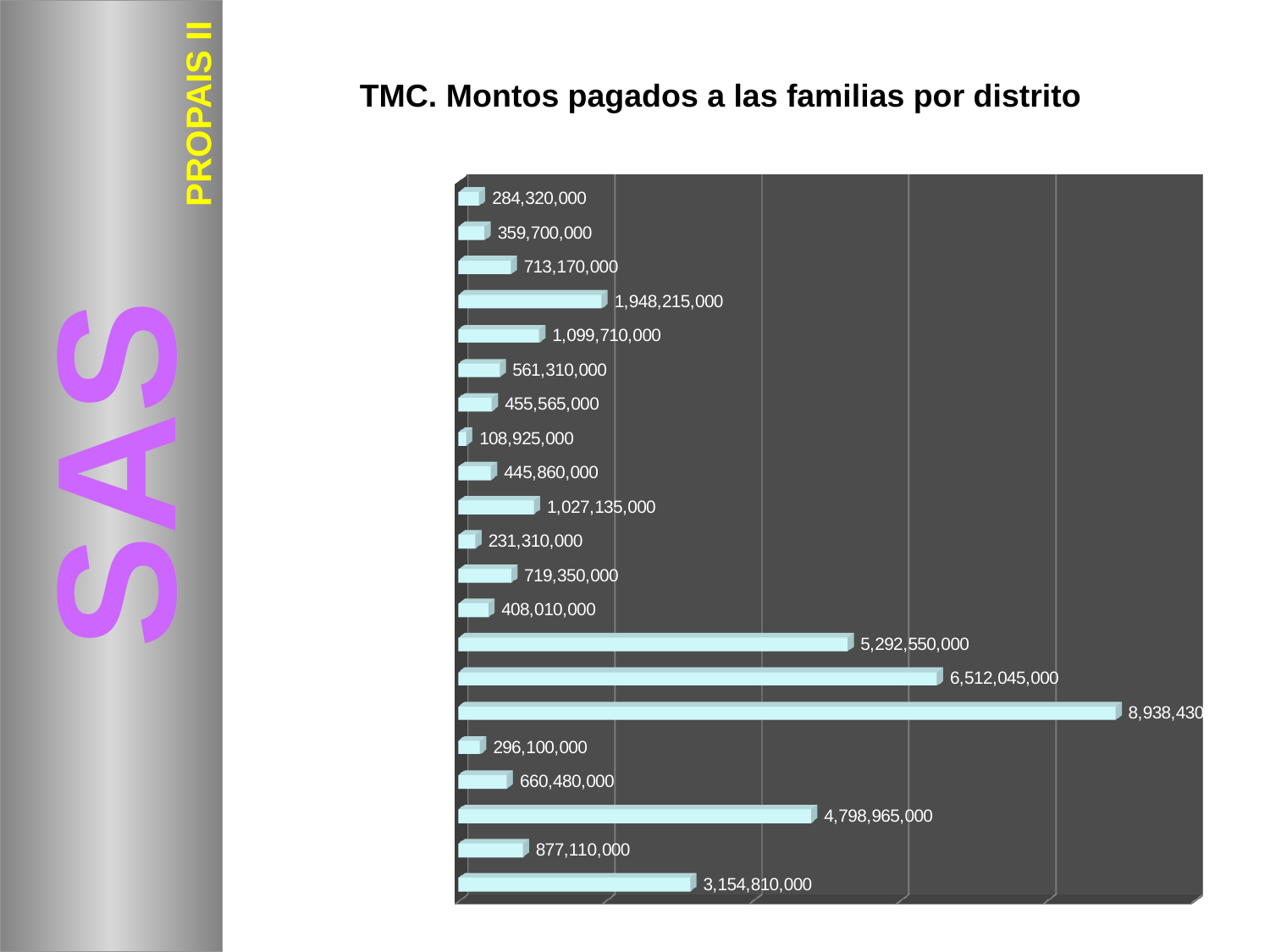
Which is larger, the bar labelled 6,512,045,000 or the bar labelled 5,292,550,000? 6,512,045,000 What is the value of the fourth bar from the top? 1,948,215,000 What is the difference between the bottom bar (3,154,810,000) and the top bar (284,320,000)? 2,870,490,000 What is the value of the third bar from the bottom? 4,798,965,000 What kind of chart is shown on the slide? bar chart What is the value of the second bar from the bottom? 877,110,000 What is the smallest value shown in the chart? 108,925,000 What is the value of the bottom bar in the chart? 3,154,810,000 What is the difference between the bottom bar (3,154,810,000) and the second bar from the bottom (877,110,000)? 2,277,700,000 What is the title of the chart? TMC. Montos pagados a las familias por distrito What is the value of the top bar in the chart? 284,320,000 How many bars does the chart contain? 21